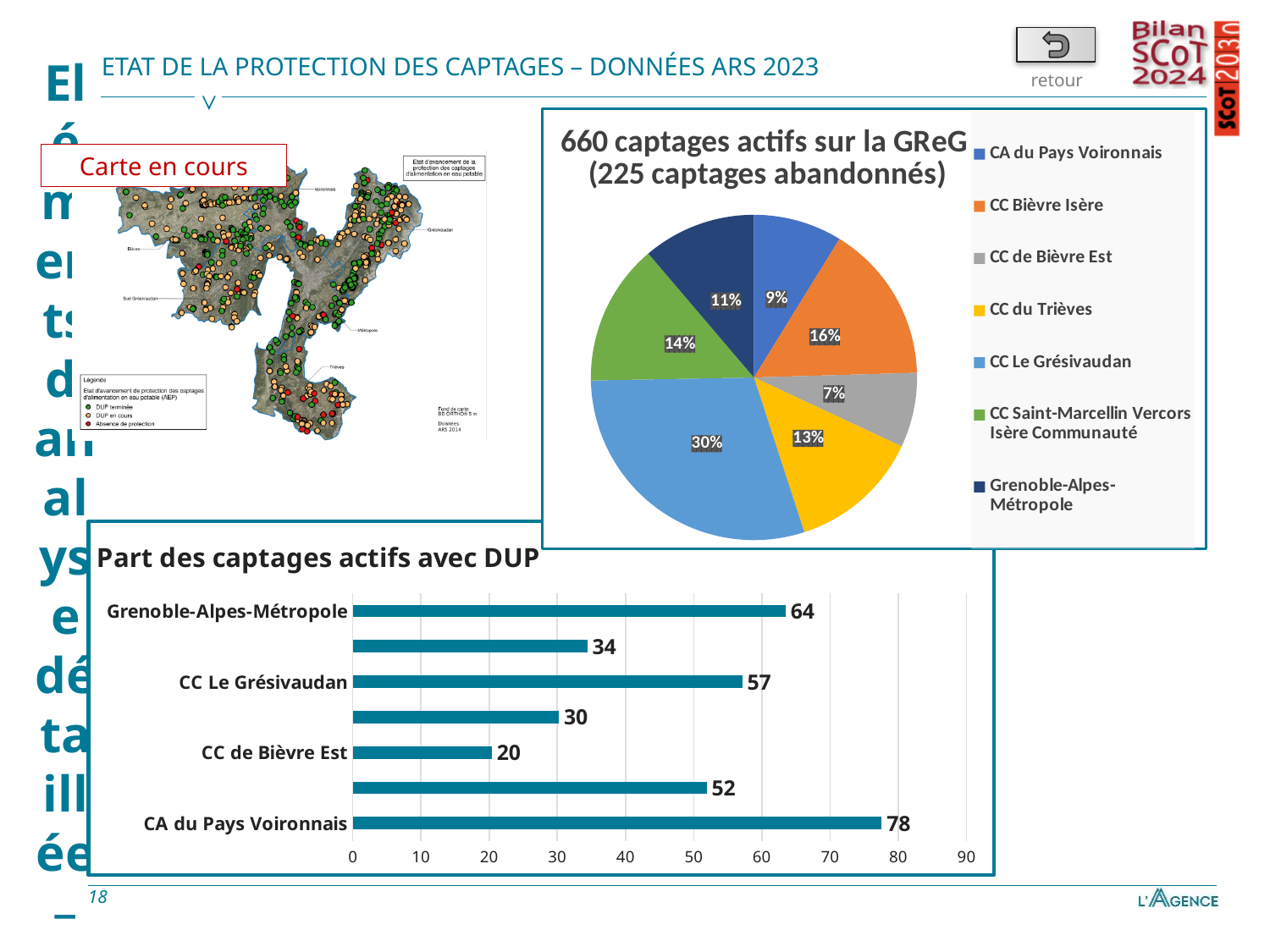
In the chart 'Part des captages actifs avec DUP', what is the value for CA du Pays Voironnais? 78 In the chart 'Part des captages actifs avec DUP', what is the value for CC Le Grésivaudan? 57 In the pie chart '660 captages actifs sur la GReG', what is the difference between the shares of CC Saint-Marcellin Vercors Isère Communauté and Grenoble-Alpes-Métropole? 3% In the pie chart '660 captages actifs sur la GReG', what share does CC de Bièvre Est hold? 7% What kind of chart is 'Part des captages actifs avec DUP'? Bar chart In the pie chart '660 captages actifs sur la GReG', which is larger: the share of CC Bièvre Isère or the share of CC du Trièves? CC Bièvre Isère In the pie chart '660 captages actifs sur la GReG', how many categories does the legend list? 7 In the pie chart '660 captages actifs sur la GReG', what share does CC Le Grésivaudan hold? 30% In the chart 'Part des captages actifs avec DUP', which labelled category has the lowest value? CC de Bièvre Est In the chart 'Part des captages actifs avec DUP', what is the difference between the values for Grenoble-Alpes-Métropole and CC de Bièvre Est? 44 In the pie chart '660 captages actifs sur la GReG', which category has the smallest slice? CC de Bièvre Est In the pie chart '660 captages actifs sur la GReG', which category has the largest slice? CC Le Grésivaudan